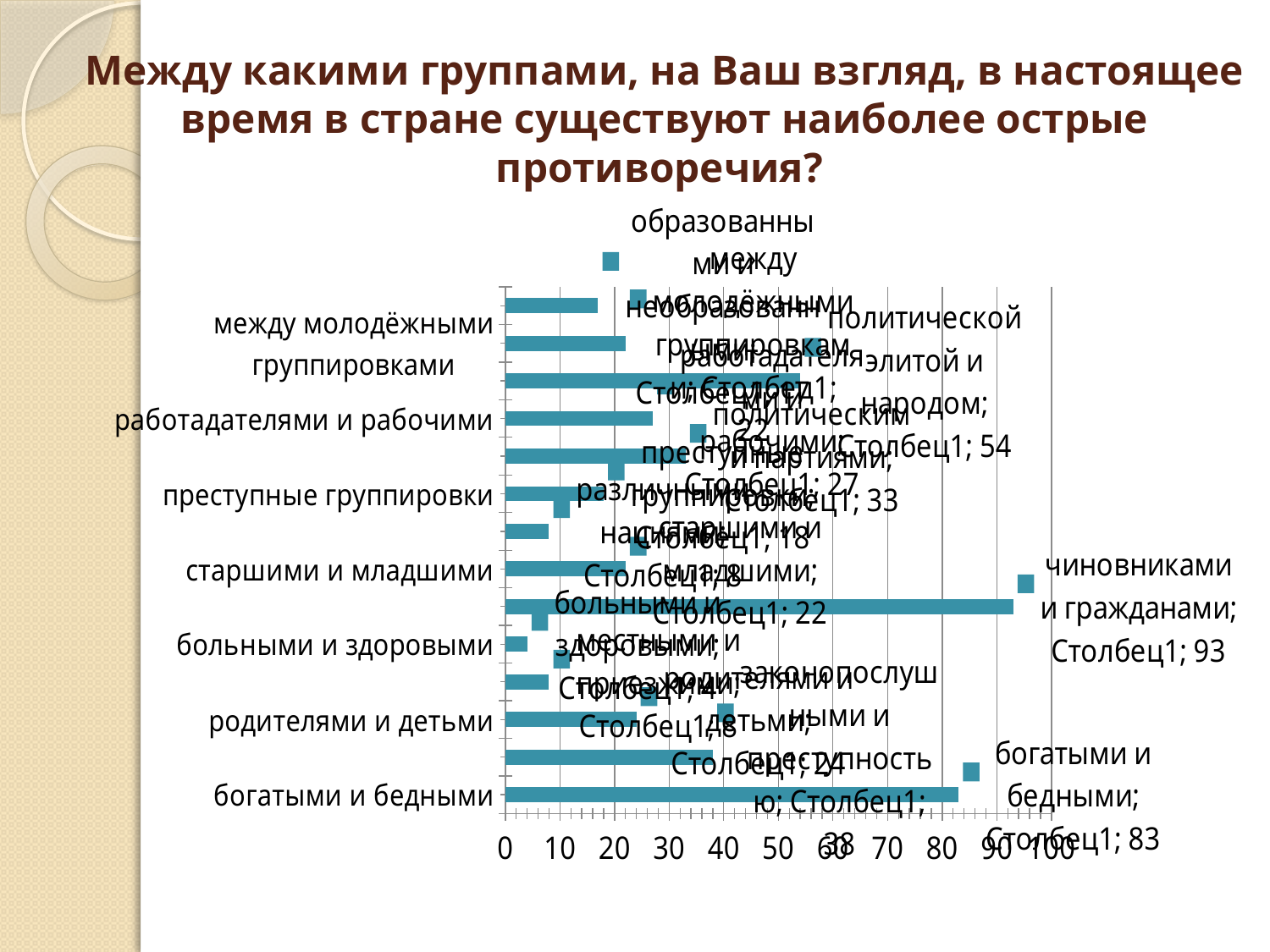
What is the difference between the values for "чиновниками и гражданами" and "богатыми и бедными"? 10 Which group pair has the highest value on the chart? чиновниками и гражданами What is the value for "чиновниками и гражданами"? 93 Is the value for "больными и здоровыми" greater or less than 10? less What kind of chart is shown on the slide? bar chart What is the value for "политической элитой и народом"? 54 Which is larger: the value for "богатыми и бедными" or the value for "работадателями и рабочими"? богатыми и бедными Is the value for "между молодёжными группировками" greater or less than 30? less What is the value for "богатыми и бедными"? 83 Is the value for "работадателями и рабочими" greater or less than 40? less What series name appears in the data labels of the chart? Столбец1